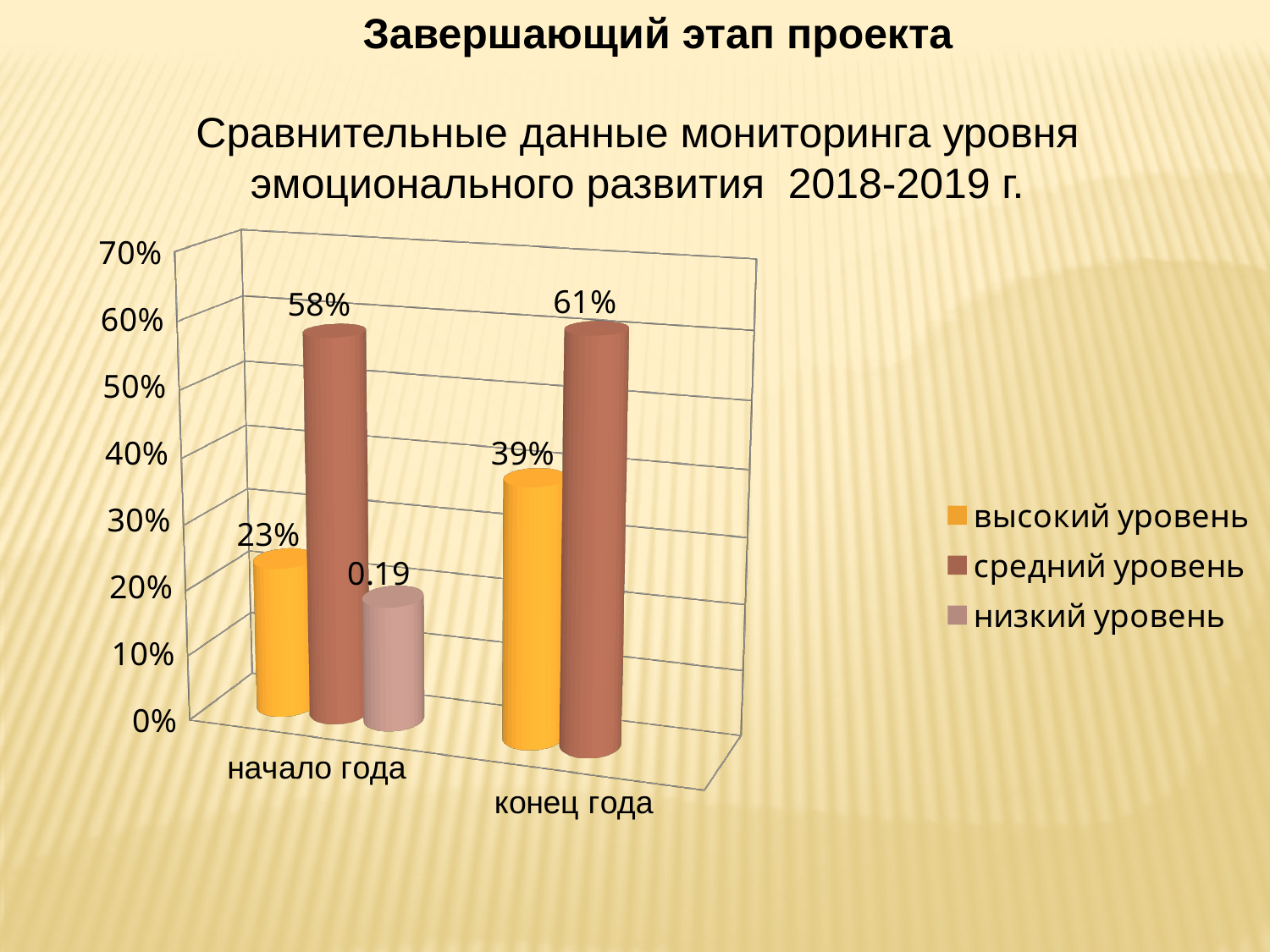
What kind of chart is shown on the slide? bar chart Which is larger: средний уровень at начало года or средний уровень at конец года? конец года What is the value for низкий уровень at начало года? 0.19 What is the difference between the высокий уровень values at конец года and начало года? 16% What is the value for средний уровень at начало года? 58% What is the value for высокий уровень at начало года? 23% Does the value for высокий уровень rise or fall from начало года to конец года? rise How many series does the legend list? 3 Which series has the lowest value at начало года? низкий уровень Which series has the highest value at конец года? средний уровень What is the value for средний уровень at конец года? 61% What is the value for высокий уровень at конец года? 39%